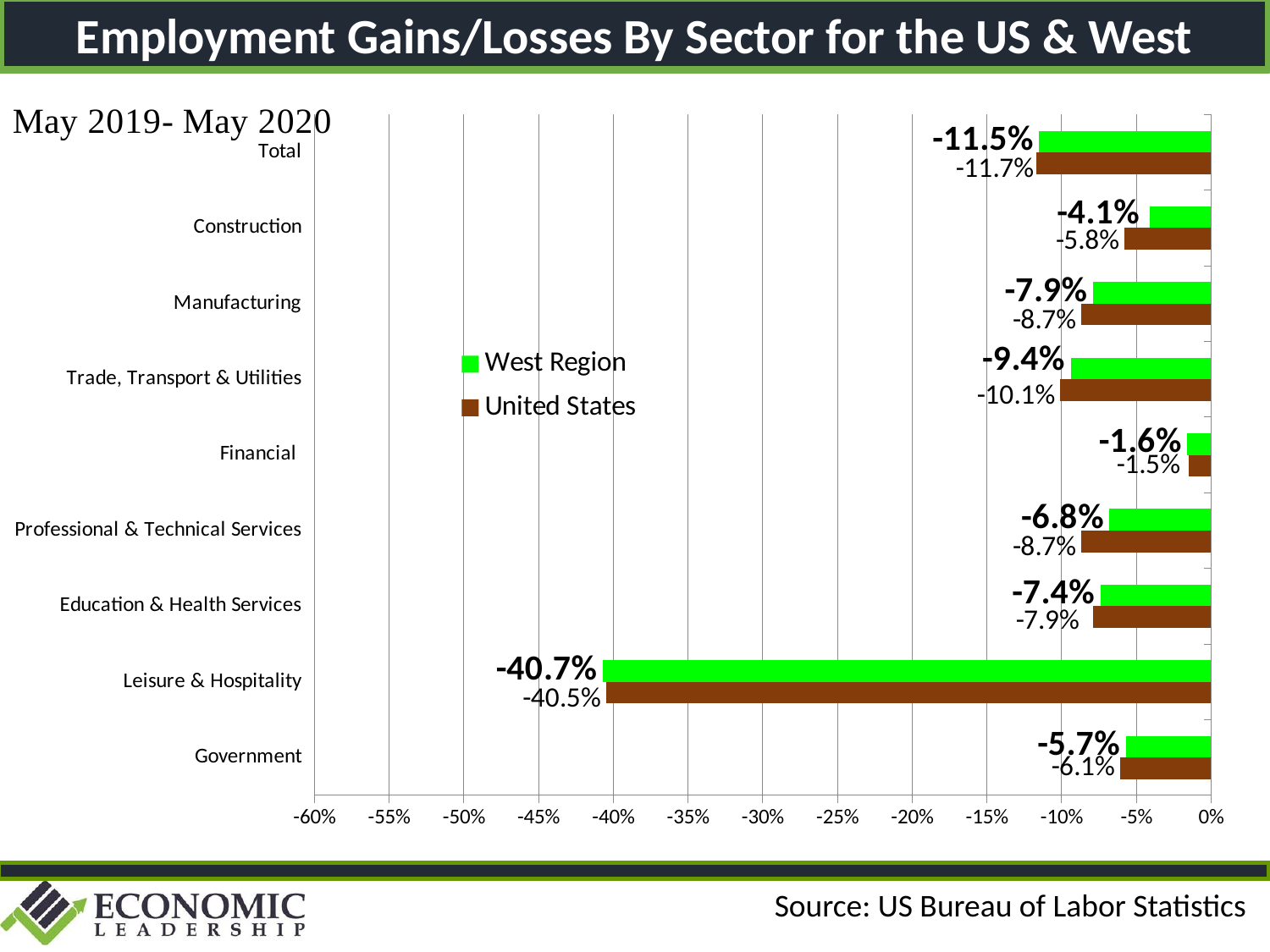
What is the West Region value for Construction? -4.1% By how many percentage points does the United States decline in Construction exceed the West Region decline? 1.7 percentage points For Professional & Technical Services, which series shows the larger decline, West Region or United States? United States What is the West Region value for Leisure & Hospitality? -40.7% What is the United States value for Trade, Transport & Utilities? -10.1% Which sector shows the smallest employment loss for the United States? Financial How many sectors (categories) are shown on the chart? 9 What is the United States value for Total? -11.7% How many series does the legend list? 2 Which sector shows the largest employment loss for the West Region? Leisure & Hospitality What time period does the chart cover, according to the label above the chart? May 2019- May 2020 What type of chart is shown on the slide? Bar chart